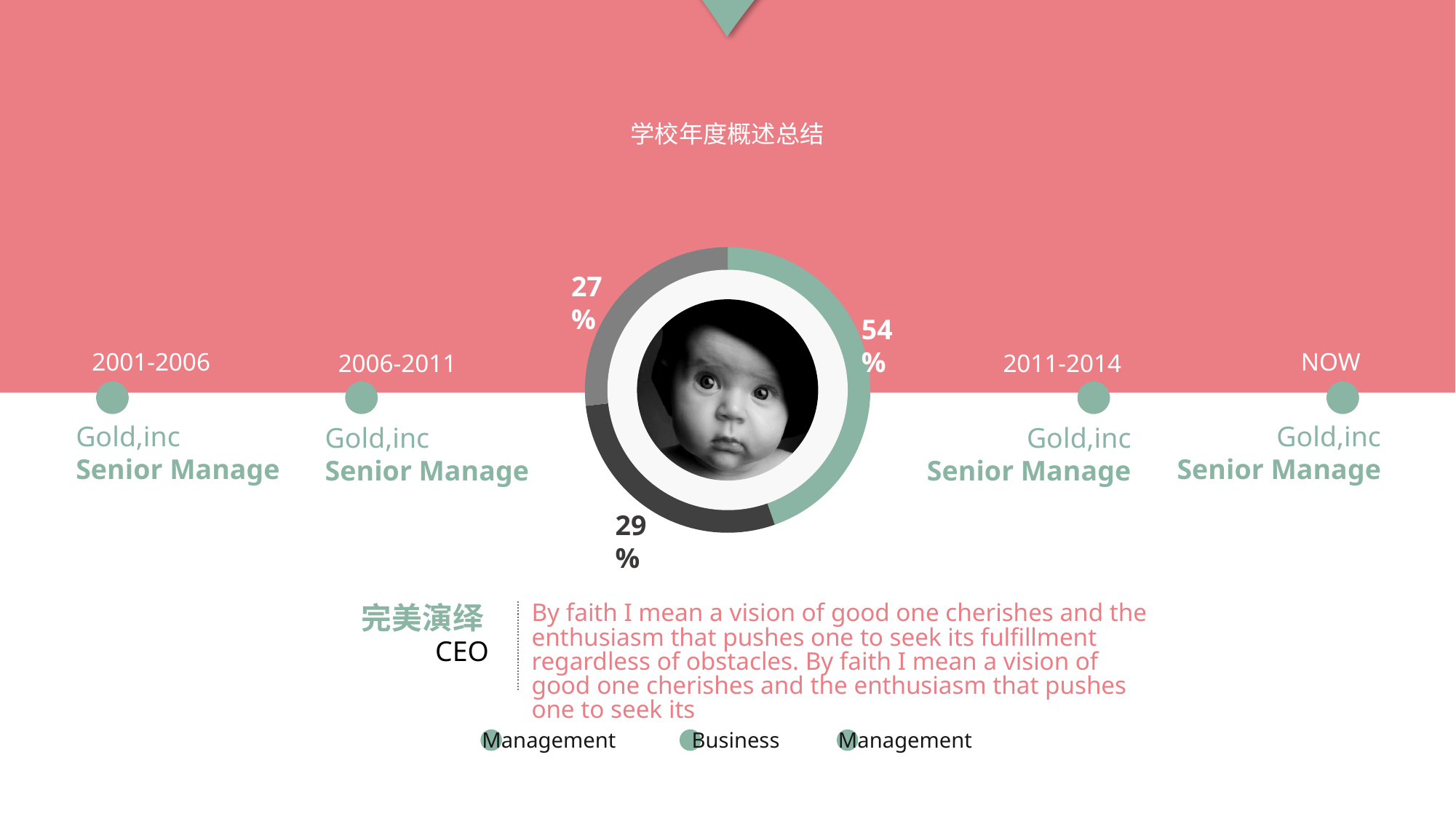
What is the value of the largest slice of the pie chart? 54% What is the value of the smallest slice of the pie chart? 27% Which is larger, the dark grey slice at the bottom or the light grey slice at the upper left? the dark grey slice at the bottom (29%) What value is labelled on the light grey slice at the upper left of the pie chart? 27% What is the difference between the 29% slice and the 27% slice? 2 percentage points What is the difference between the 54% slice and the 27% slice? 27 percentage points How many entries does the legend below the chart list? 3 What value is labelled on the green slice of the pie chart? 54% What kind of chart is shown in the centre of the slide? pie chart How many slices does the pie chart have? 3 What value is labelled on the dark grey slice at the bottom of the pie chart? 29%